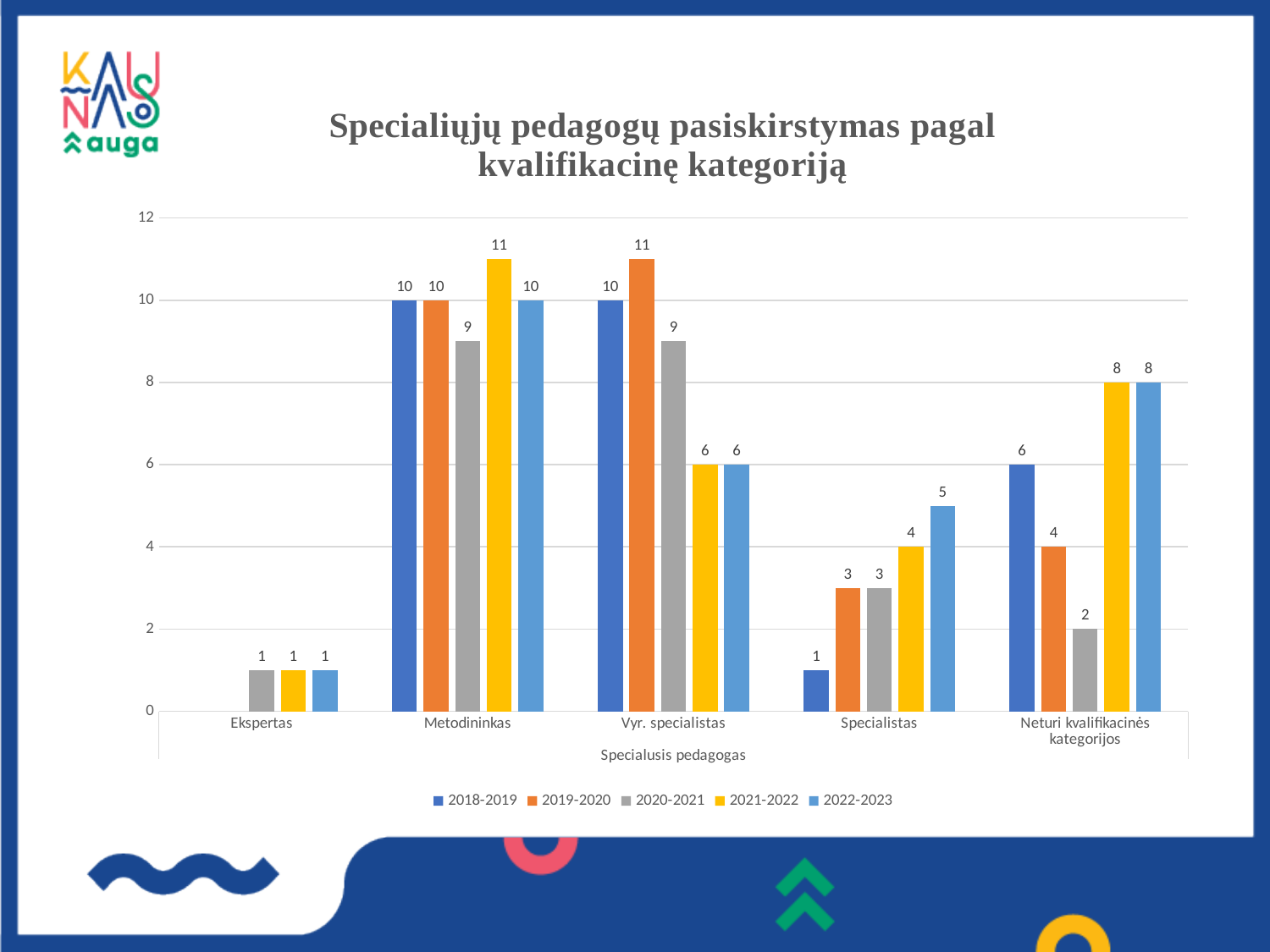
Do the values for Specialistas rise or fall from the 2018-2019 series to the 2022-2023 series? Rise Which category has the lowest value in the 2018-2019 series among those with a bar shown? Specialistas What kind of chart is shown on the slide? Bar chart Which is larger for Vyr. specialistas: the 2019-2020 value or the 2021-2022 value? 2019-2020 What is the value for Vyr. specialistas in the 2019-2020 series? 11 What is the value for Metodininkas in the 2021-2022 series? 11 What is the value for Specialistas in the 2022-2023 series? 5 Which category has the highest value in the 2022-2023 series? Metodininkas What is the difference between the 2018-2019 and 2020-2021 values for Neturi kvalifikacinės kategorijos? 4 How many series does the legend list? 5 How many categories are shown on the x axis? 5 What is the value for Neturi kvalifikacinės kategorijos in the 2020-2021 series? 2